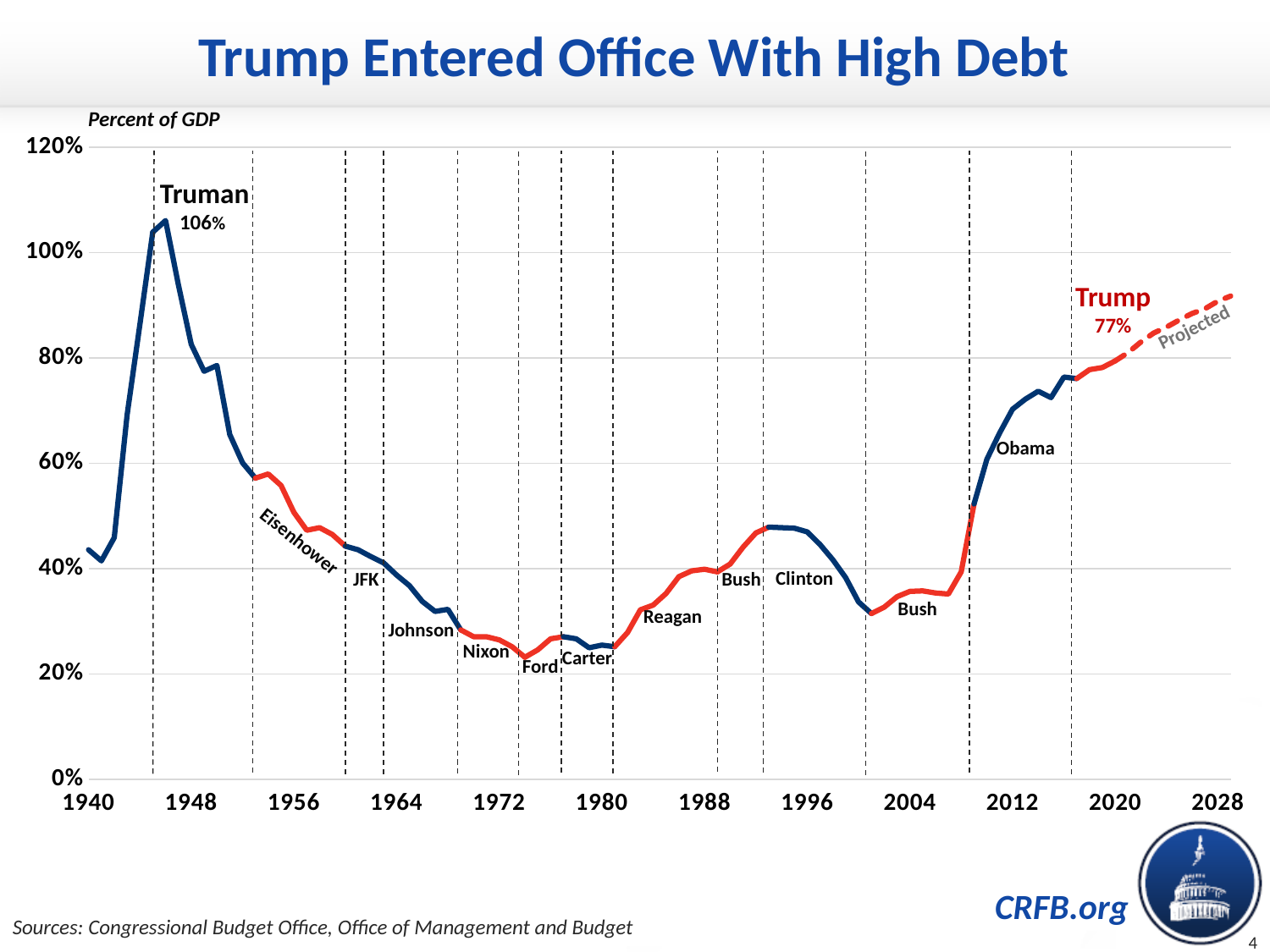
What is the title of the chart? Trump Entered Office With High Debt Is the value for 2012 greater or less than 60%? greater Is the value for 1940 greater or less than 60%? less What is the debt as a percent of GDP labeled for Trump? 77% Is the value for 1980 greater or less than 40%? less What does the dashed portion of the line at the right end of the chart represent? Projected Which labeled value is larger, the Truman peak or the Trump value? Truman What kind of chart is shown on the slide? line chart Does the line rise or fall between 2008 and 2016? rise What is the difference between the labeled Truman peak and the labeled Trump value? 29 percentage points Does the line rise or fall between 1948 and 1972? fall What is the debt as a percent of GDP labeled at the peak under Truman? 106%